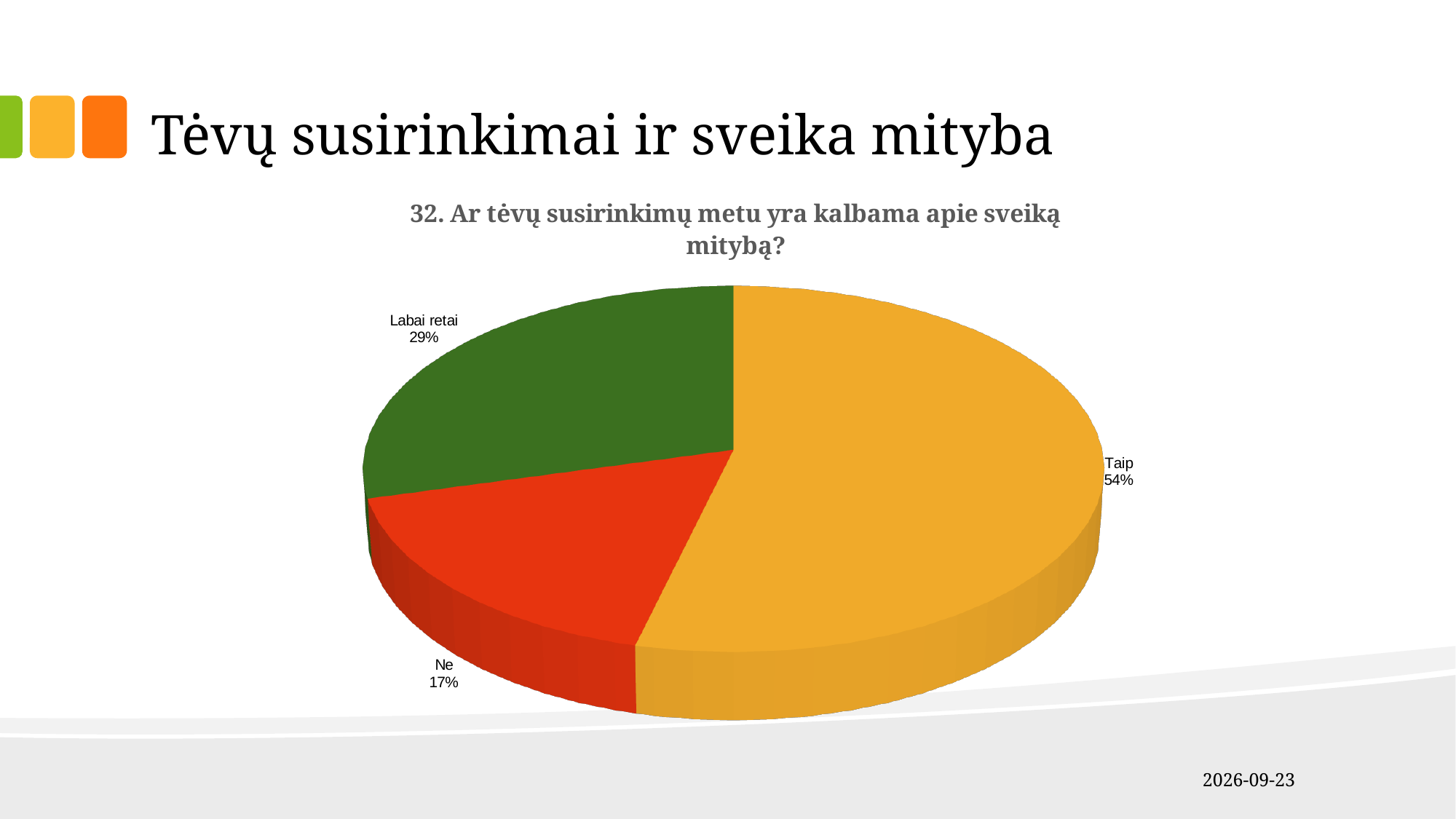
What colour is the "Taip" slice? orange Which category has the largest slice of the pie? Taip How many slices does the pie chart have? 3 What share of the pie does "Taip" have? 54% What share of the pie does "Labai retai" have? 29% Which is larger, the share for "Labai retai" or the share for "Ne"? Labai retai What share of the pie does "Ne" have? 17% What is the difference in percentage points between "Taip" and "Ne"? 37 Which category has the smallest slice of the pie? Ne What is the difference in percentage points between "Labai retai" and "Ne"? 12 What is the title of the chart? 32. Ar tėvų susirinkimų metu yra kalbama apie sveiką mitybą? What kind of chart is shown on the slide? pie chart